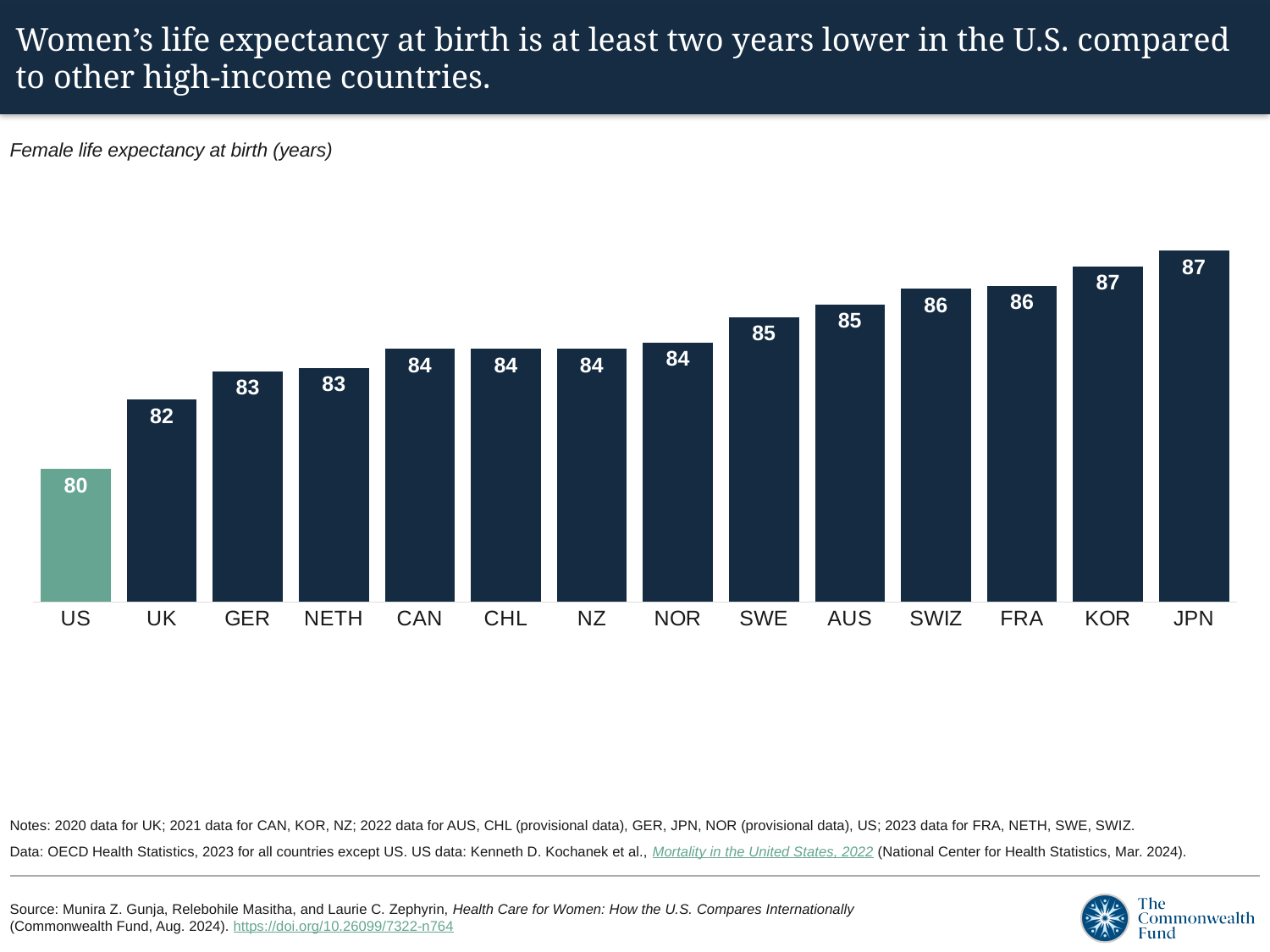
Which country has the lowest female life expectancy at birth? US What is the female life expectancy at birth for SWE? 85 What is the female life expectancy at birth for the US? 80 Do the values rise or fall from left to right across the chart? Rise Which has a higher female life expectancy at birth, GER or AUS? AUS What is the female life expectancy at birth for KOR? 87 What is the difference in female life expectancy at birth between FRA and UK? 4 How many countries are shown in the chart? 14 Which has a higher female life expectancy at birth, UK or NOR? NOR What is the difference in female life expectancy at birth between JPN and the US? 7 Which bar is shown in a different colour from the others? US What kind of chart is shown on the slide? Bar chart